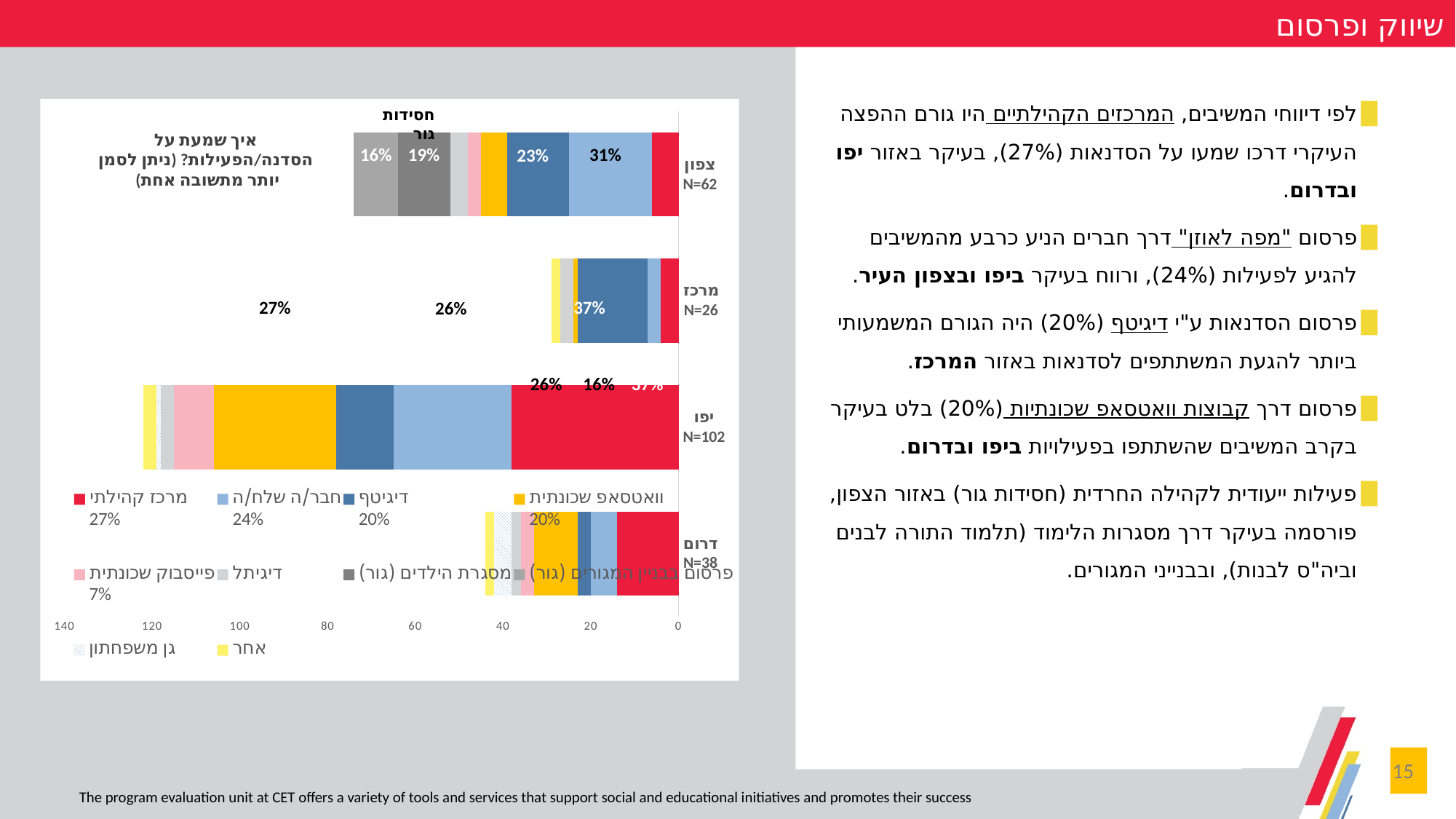
In the צפון bar, what percentage is labelled for the חבר/ה שלח/ה (light blue) segment? 31% Which region category has the longest total bar? יפו In the מרכז bar, what percentage is labelled for the דיגיטף (dark blue) segment? 37% What is the sample size (N) shown for the יפו category? N=102 Is the total length of the יפו bar greater or less than 100? greater In the צפון bar, what percentage is labelled for the דיגיטף (dark blue) segment? 23% Which region category has the shortest total bar? מרכז In the צפון bar, what is the difference between the חבר/ה שלח/ה segment (31%) and the דיגיטף segment (23%)? 8 percentage points How many region categories (bars) does the chart show? 4 In the צפון bar, which is larger: the מסגרת הילדים (גור) segment or the בבניין המגורים (גור) segment? מסגרת הילדים (גור) What kind of chart is shown on the slide? Stacked bar chart How many series does the chart legend list? 10